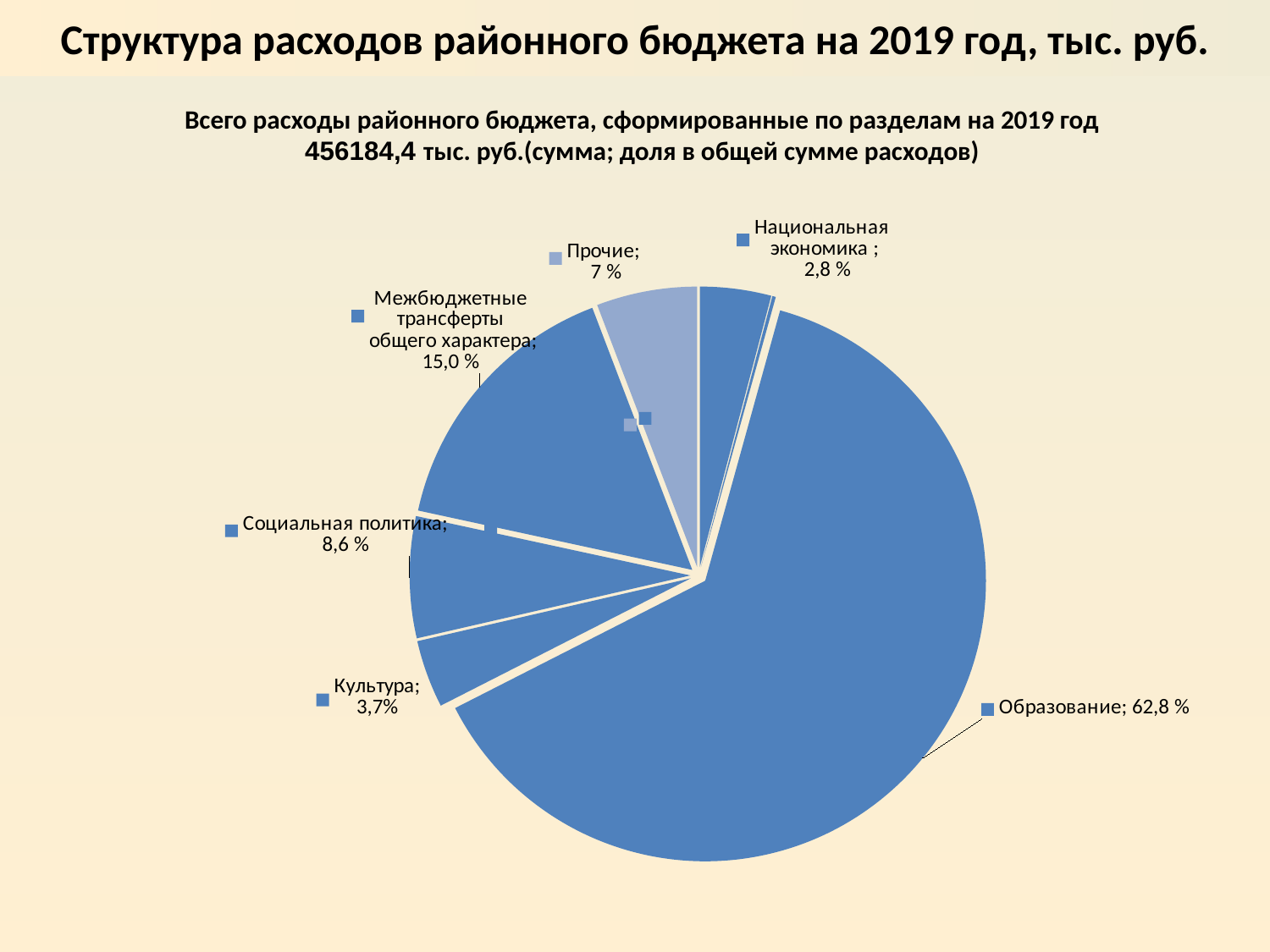
What share is shown for Прочие? 7 % What share is shown for Национальная экономика? 2,8 % Which is larger: the share for Социальная политика or the share for Прочие? Социальная политика What kind of chart is shown on the slide? pie chart What is the difference in percentage points between the shares of Образование and Межбюджетные трансферты общего характера? 47,8 What share is shown for Социальная политика? 8,6 % Which category has the largest share of expenditures? Образование Which labelled category has the smallest share of expenditures? Национальная экономика What total amount of district budget expenditures for 2019 is stated above the chart? 456184,4 тыс. руб.